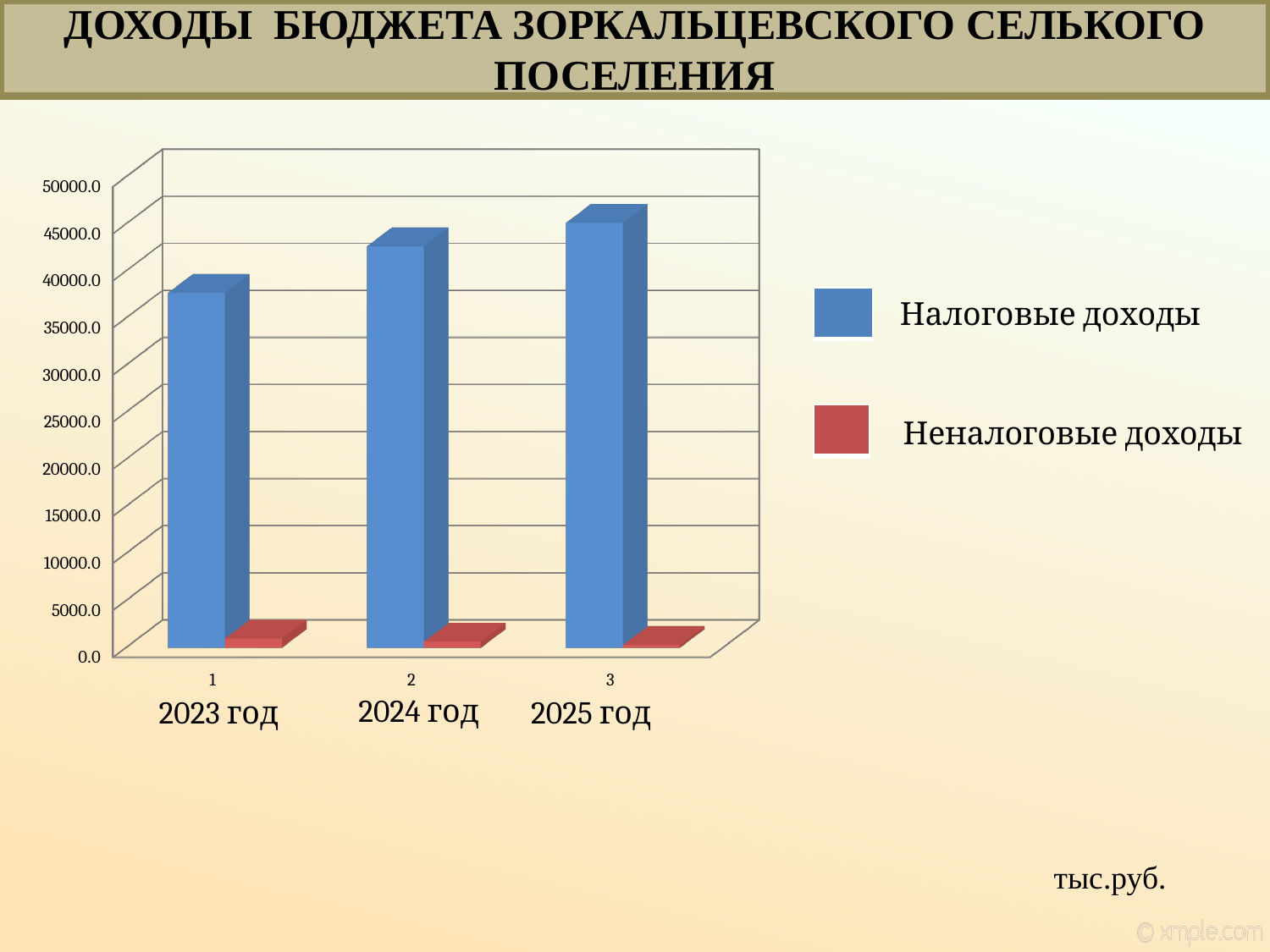
Is the value for Налоговые доходы in 2023 год greater or less than 35000.0? greater Which colour represents Неналоговые доходы in the legend? red How many series does the legend list? 2 In what units are the values on the chart given, according to the note on the slide? тыс.руб. Do the values for Налоговые доходы rise or fall from 2023 год to 2025 год? rise Is the value for Неналоговые доходы in 2025 год greater or less than 5000.0? less Which is larger: Налоговые доходы in 2024 год or in 2023 год? 2024 год What kind of chart is shown on the slide? bar chart Which year has the lowest value for Налоговые доходы? 2023 год Which year has the highest value for Налоговые доходы? 2025 год How many years (categories) are shown on the x axis? 3 Is the value for Налоговые доходы in 2024 год greater or less than 40000.0? greater